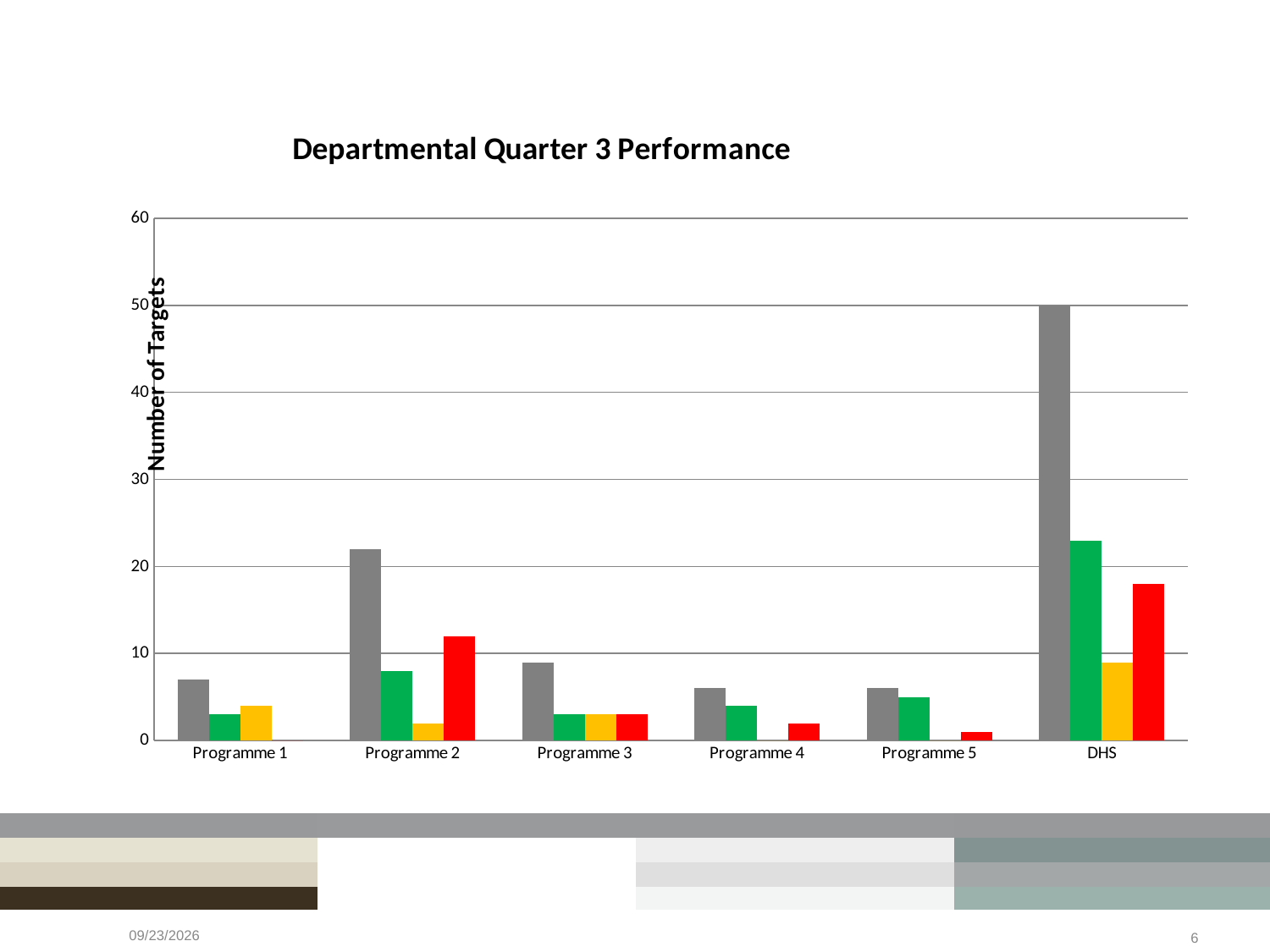
What is the label on the vertical axis? Number of Targets Which category has the tallest grey bar? DHS How many categories are shown along the x axis? 6 Is the green bar for DHS greater or less than 20? greater Which is larger, the grey bar for Programme 2 or the grey bar for Programme 3? Programme 2 What is the title of the chart? Departmental Quarter 3 Performance Is the grey bar for DHS greater or less than 40? greater Which is larger for DHS, the red bar or the yellow bar? red bar Is the grey bar for Programme 2 greater or less than 20? greater What kind of chart is shown on the slide? bar chart